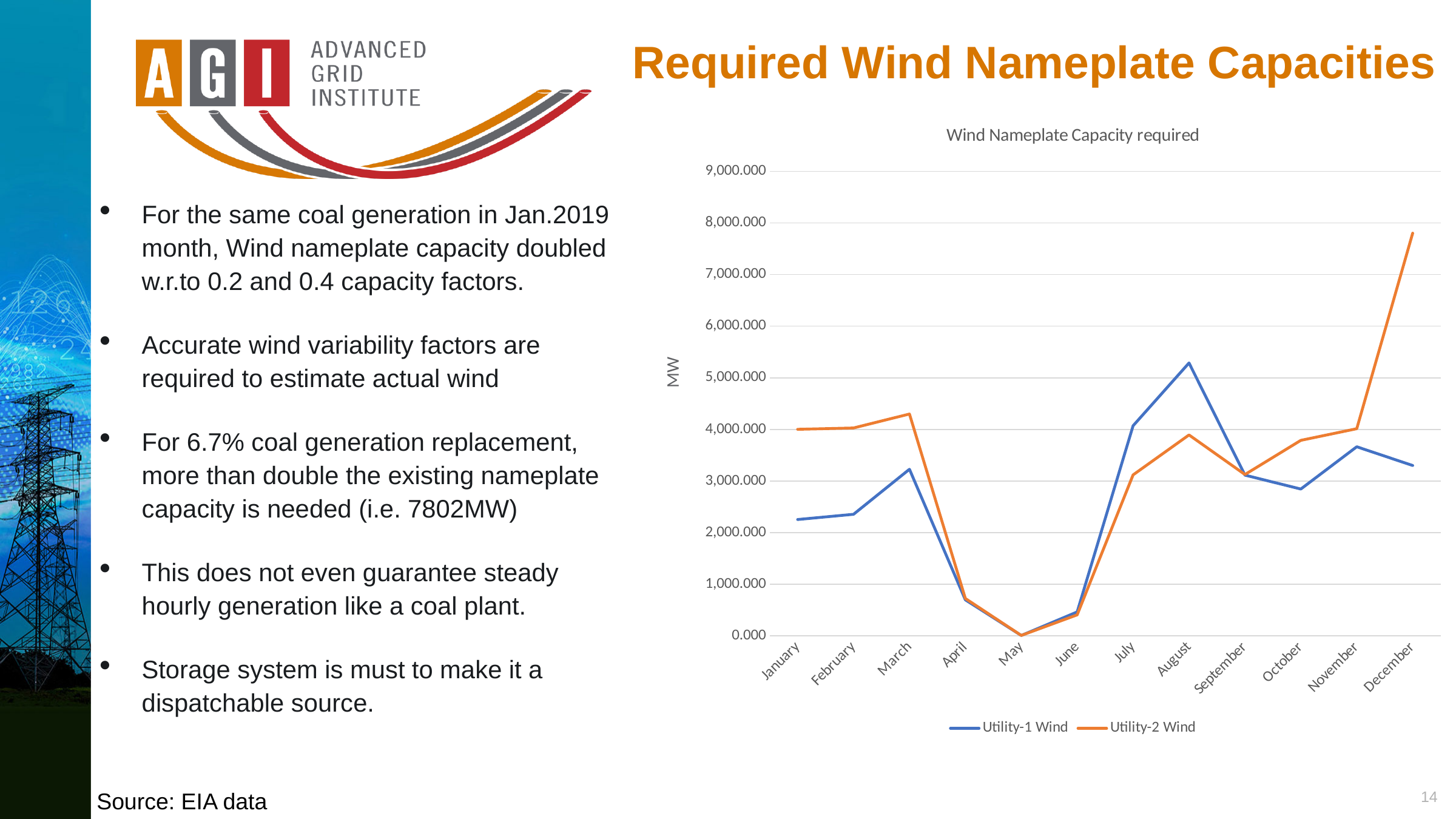
In which month does the Utility-2 Wind series reach its highest value? December What kind of chart is shown on the slide? Line chart How many months are plotted along the x axis of the chart? 12 Do the values of both series rise or fall from March to May? fall Is the value for Utility-1 Wind in January greater or less than 3,000.000? less In December, which series has the larger value, Utility-1 Wind or Utility-2 Wind? Utility-2 Wind In August, which series has the larger value, Utility-1 Wind or Utility-2 Wind? Utility-1 Wind In which month does the Utility-1 Wind series reach its highest value? August Is the value for Utility-2 Wind in December greater or less than 7,000.000? greater In which month does the Utility-1 Wind series reach its lowest value? May Is the value for Utility-1 Wind in August greater or less than 5,000.000? greater How many series does the chart legend list? 2